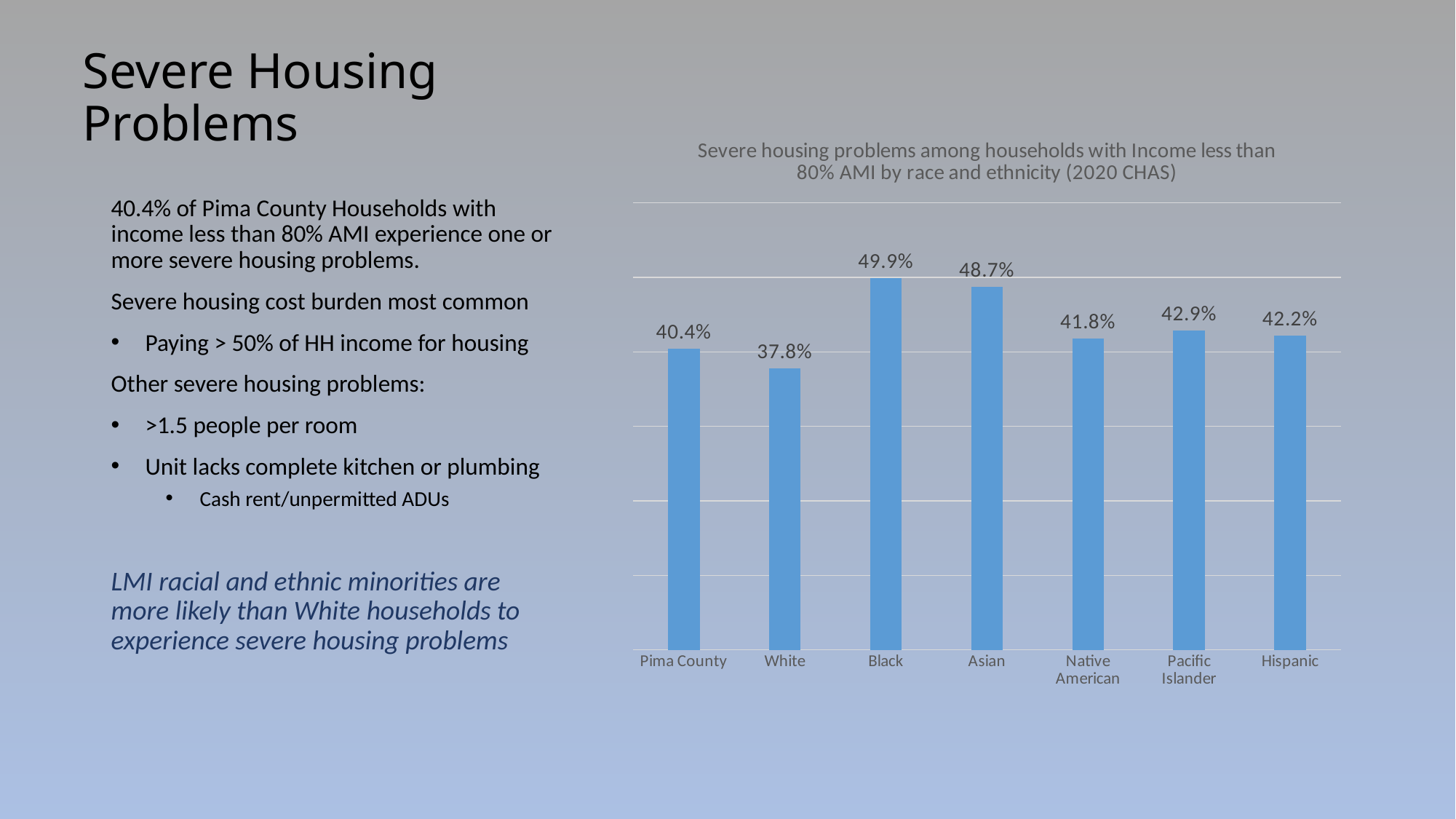
Which category has the lowest value in the chart? White Which is larger, the value for Asian or the value for Native American? Asian Which category has the highest value in the chart? Black What is the value for White households in the chart? 37.8% Which is larger, the value for Pacific Islander or the value for Hispanic? Pacific Islander What is the difference between the values for Black and White households? 12.1% What is the difference between the values for Asian and Pima County? 8.3% What is the value for Native American households in the chart? 41.8% What kind of chart is shown on the slide? Bar chart What is the title of the chart? Severe housing problems among households with Income less than 80% AMI by race and ethnicity (2020 CHAS) What is the value for Black households in the chart? 49.9% How many categories are shown on the x axis of the chart? 7